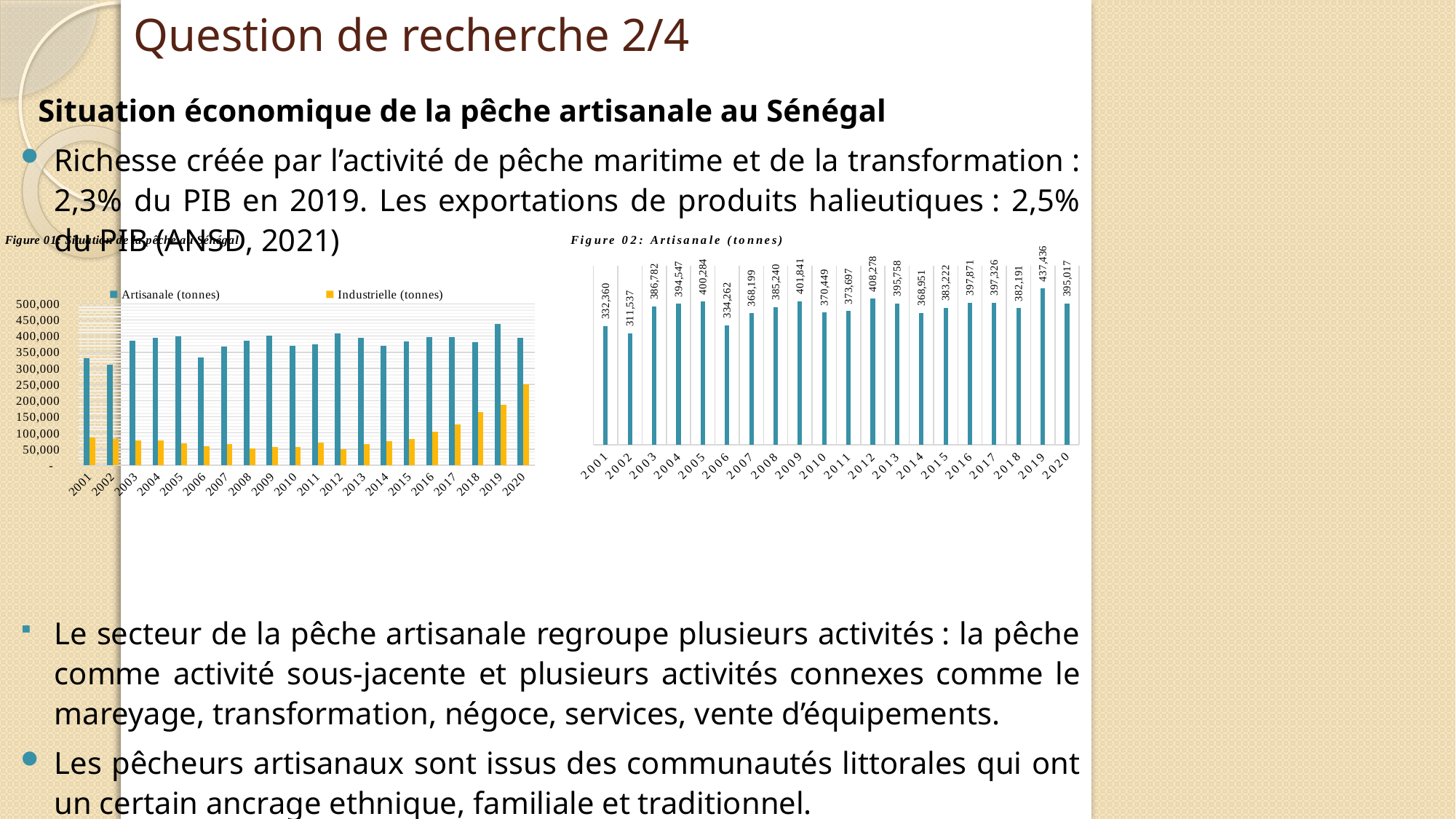
In the right chart (Figure 02: Artisanale (tonnes)), how many years are plotted? 20 In the right chart (Figure 02: Artisanale (tonnes)), which is larger, the value for 2005 or the value for 2006? 2005 In the right chart (Figure 02: Artisanale (tonnes)), which year has the lowest value? 2002 In the right chart (Figure 02: Artisanale (tonnes)), what is the value for 2019? 437,436 In the left chart, how many series does the legend list? 2 In the left chart, is the value for Industrielle (tonnes) in 2020 greater or less than 200,000? greater In the right chart (Figure 02: Artisanale (tonnes)), what is the value for 2002? 311,537 In the right chart (Figure 02: Artisanale (tonnes)), what is the value for 2012? 408,278 In the right chart (Figure 02: Artisanale (tonnes)), which year has the highest value? 2019 What kind of chart is the left chart? bar chart In the right chart (Figure 02: Artisanale (tonnes)), what is the difference between the 2019 value and the 2020 value? 42,419 In the left chart, is the value for Industrielle (tonnes) in 2012 greater or less than 100,000? less